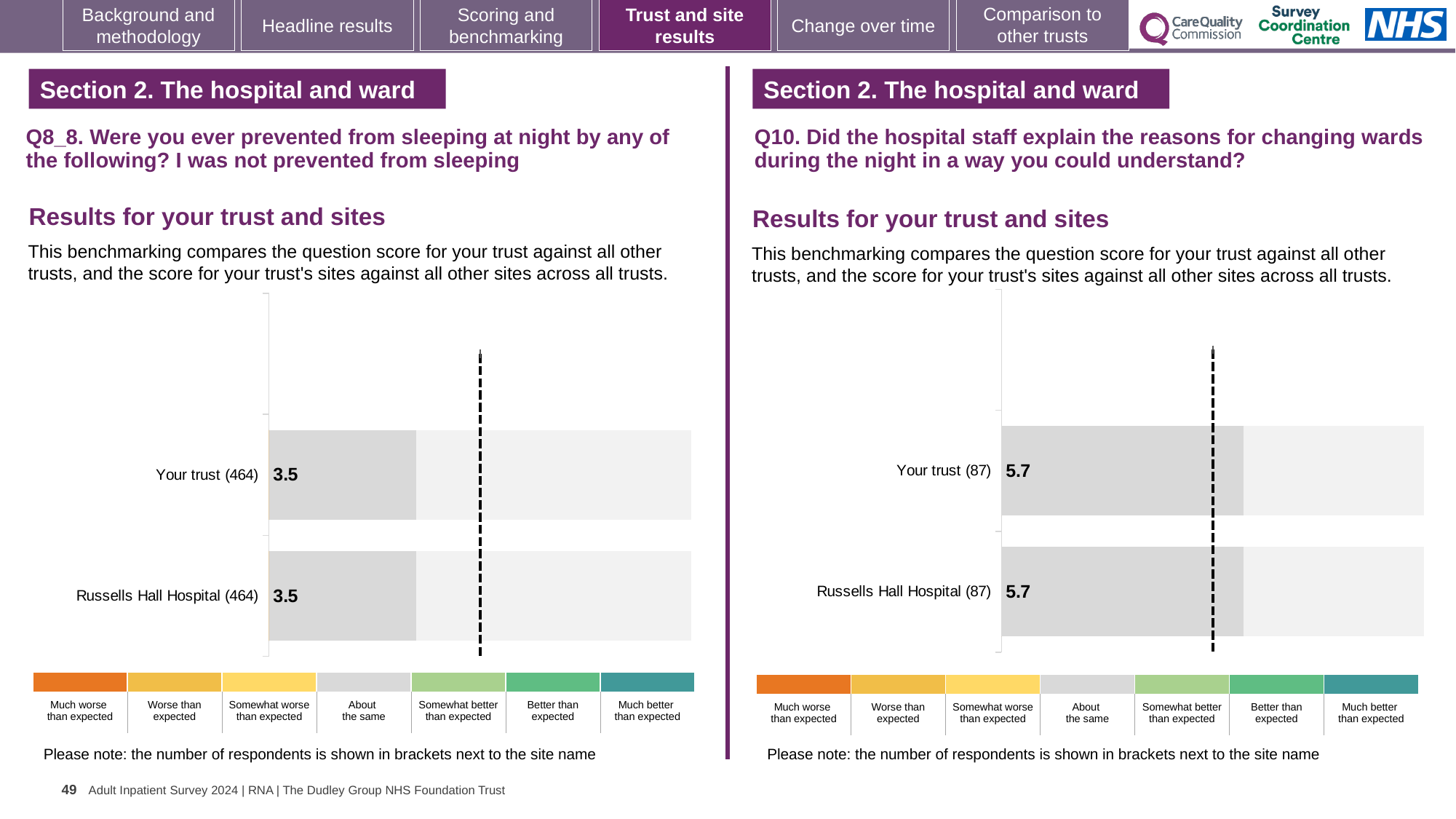
How many categories does the colour key below the right chart (Q10) list? 7 In the right chart (Q10), how many respondents are shown in brackets next to Russells Hall Hospital? 87 In the right chart (Q10), what is the score for Your trust? 5.7 In the left chart (Q8_8), what is the score for Your trust? 3.5 In the left chart (Q8_8), what is the score for Russells Hall Hospital? 3.5 In the right chart (Q10), what is the score for Russells Hall Hospital? 5.7 In the left chart (Q8_8), how many respondents are shown in brackets next to Your trust? 464 What kind of chart is used in the left chart (Q8_8)? Bar chart In the left chart (Q8_8), what is the difference between the score for Your trust and the score for Russells Hall Hospital? 0 How many bars are plotted in the left chart (Q8_8)? 2 How many bars are plotted in the right chart (Q10)? 2 In the right chart (Q10), what is the difference between the score for Your trust and the score for Russells Hall Hospital? 0